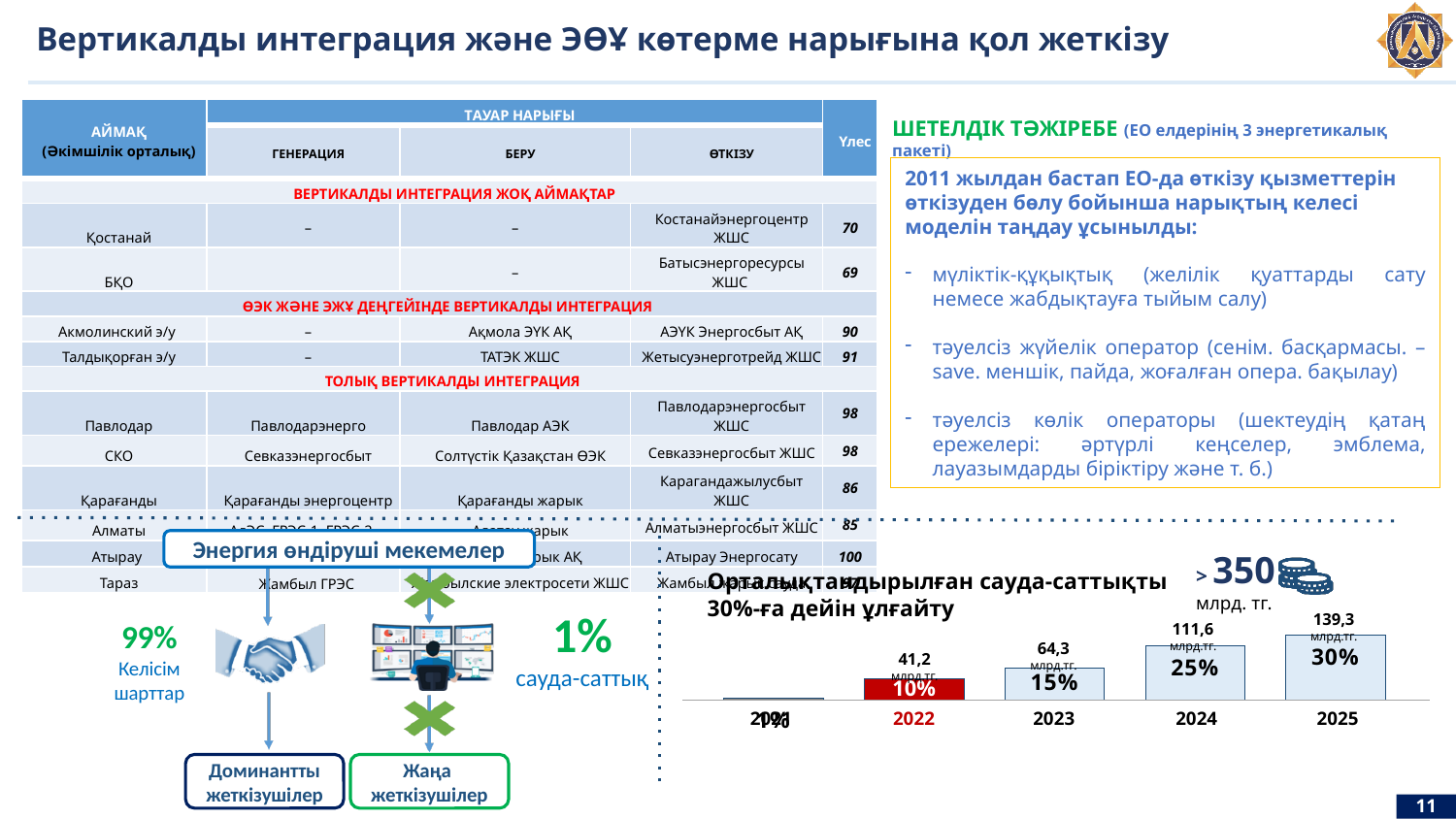
In the bottom-right bar chart, which is larger, the value for 2023 or the value for 2024? 2024 In the bottom-right bar chart, what percentage is shown for 2023? 15% In the bottom-right bar chart, what percentage is shown for 2025? 30% In the bottom-right bar chart, what value in млрд. тг. is labelled above the 2025 bar? 139,3 In the bottom-right bar chart, what value in млрд. тг. is labelled above the 2024 bar? 111,6 In the bottom-right bar chart, do the values rise or fall from 2022 to 2025? rise What type of chart is shown at the bottom right of the slide? bar chart In the bottom-right bar chart, what is the difference in percentage points between 2025 and 2022? 20 In the bottom-right bar chart, which year's bar is coloured red? 2022 In the bottom-right bar chart, what percentage is shown for 2024? 25% In the bottom-right bar chart, which year has the highest bar? 2025 In the bottom-right bar chart, what percentage is shown for 2022? 10%